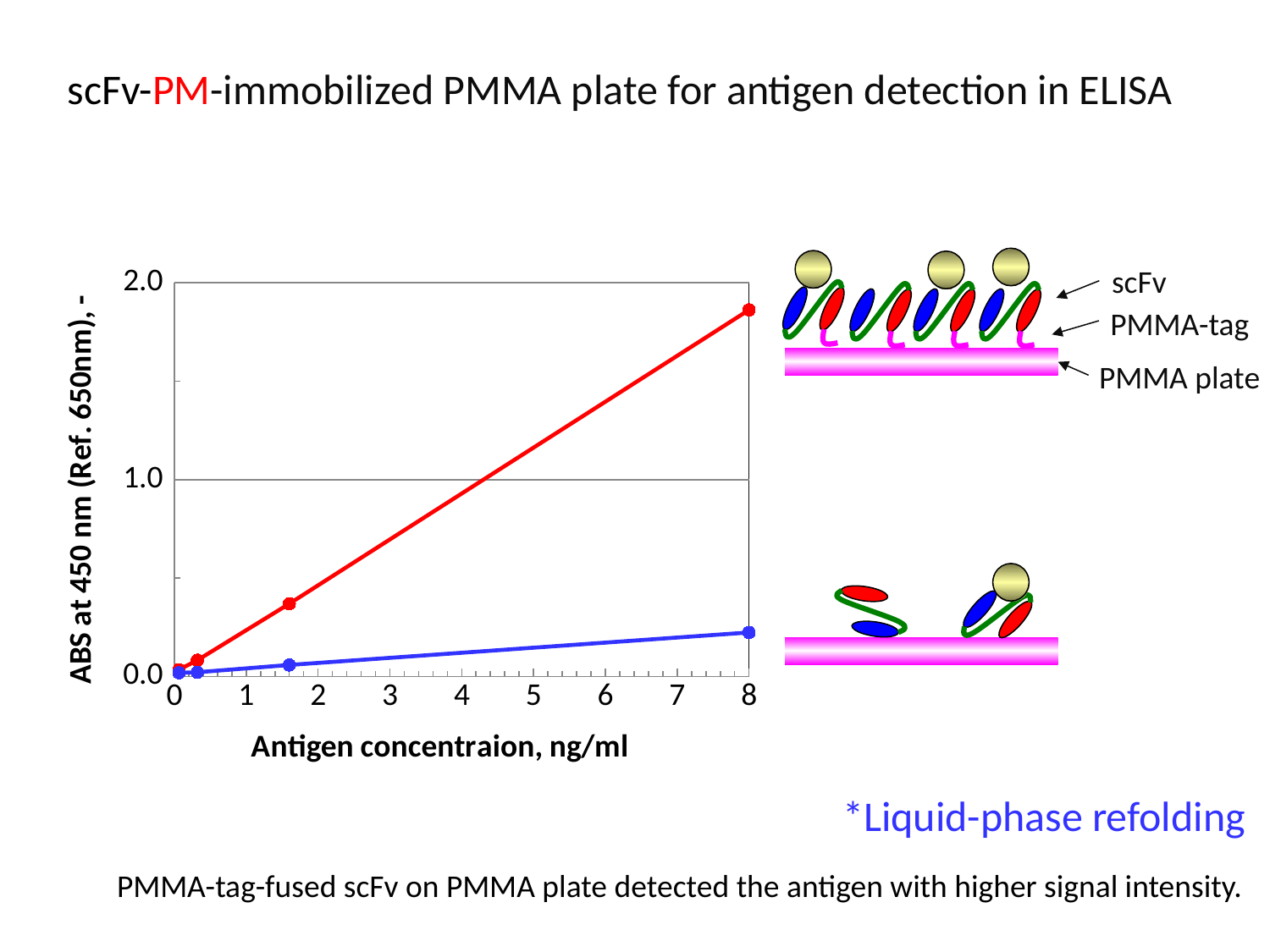
Is the value of the blue line at 8 ng/ml antigen concentration greater or less than 1.0? less Is the value of the red line at 8 ng/ml antigen concentration greater or less than 2.0? less What is the label of the x axis of the chart? Antigen concentraion, ng/ml Does the absorbance of the blue line rise or fall as antigen concentration increases? rise What is the highest value shown on the y axis of the chart? 2.0 How many lines (series) are plotted on the chart? 2 What is the label of the y axis of the chart? ABS at 450 nm (Ref. 650nm), - What kind of chart is shown on the slide? line chart How many data points does the red line have? 4 Is the value of the red line at 8 ng/ml antigen concentration greater or less than 1.0? greater Does the absorbance of the red line rise or fall as antigen concentration increases? rise At 8 ng/ml antigen concentration, which line has the higher absorbance, the red line or the blue line? the red line